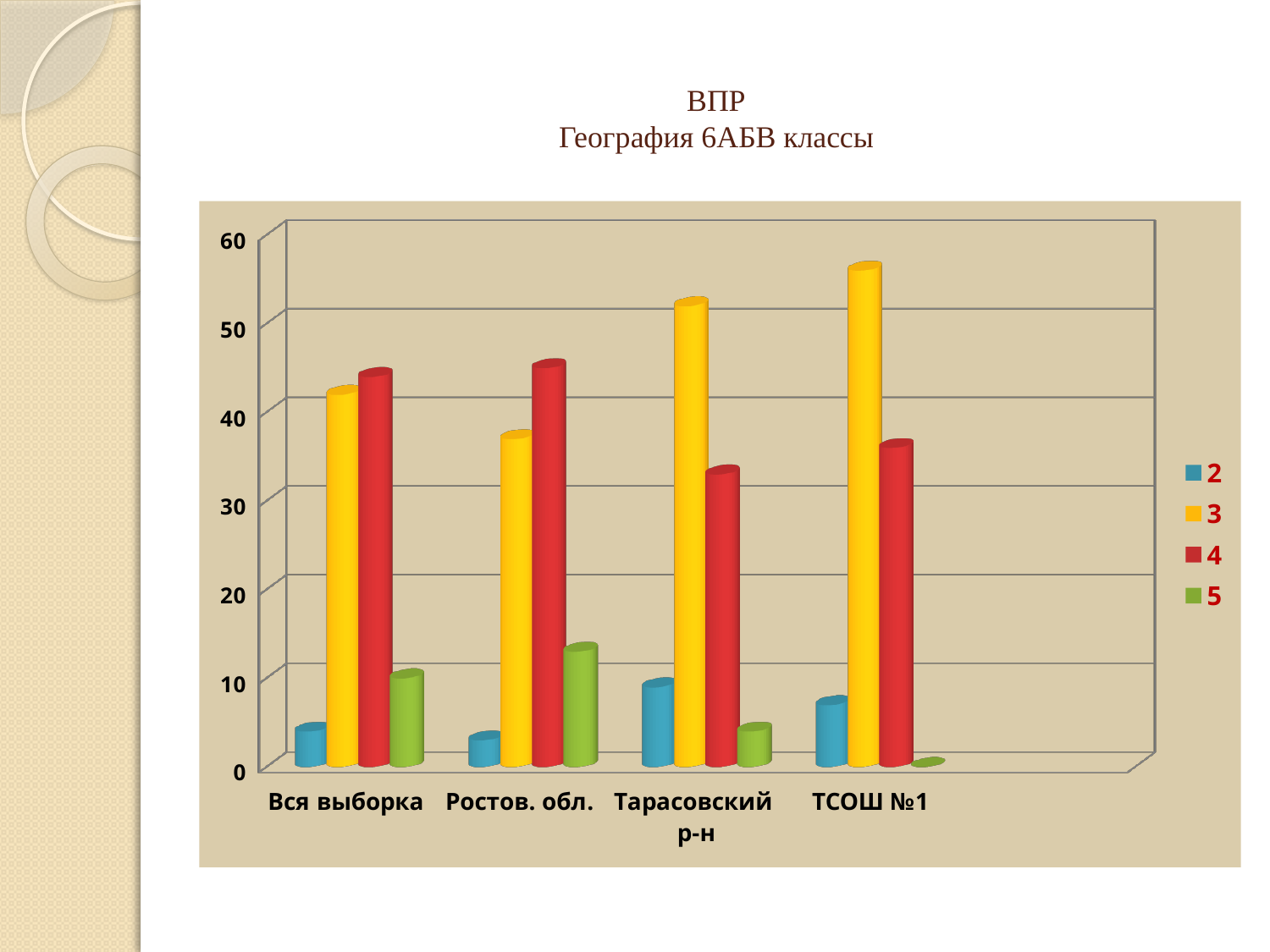
Which category has the lowest value for series 3? Ростов. обл. Which category has the lowest value for series 5? ТСОШ №1 How many categories are shown on the x axis of the chart? 4 What are the entries in the chart's legend? 2, 3, 4, 5 In Ростов. обл., which is larger: the value for series 3 or series 4? Series 4 Which category has the highest value for series 2? Тарасовский р-н How many series does the legend list? 4 Is the value for series 3 in ТСОШ №1 greater or less than 50? greater Which category has the highest value for series 3? ТСОШ №1 Is the value for series 5 in Ростов. обл. greater or less than 10? greater What kind of chart is shown on the slide? Bar chart Is the value for series 4 in Тарасовский р-н greater or less than 40? less